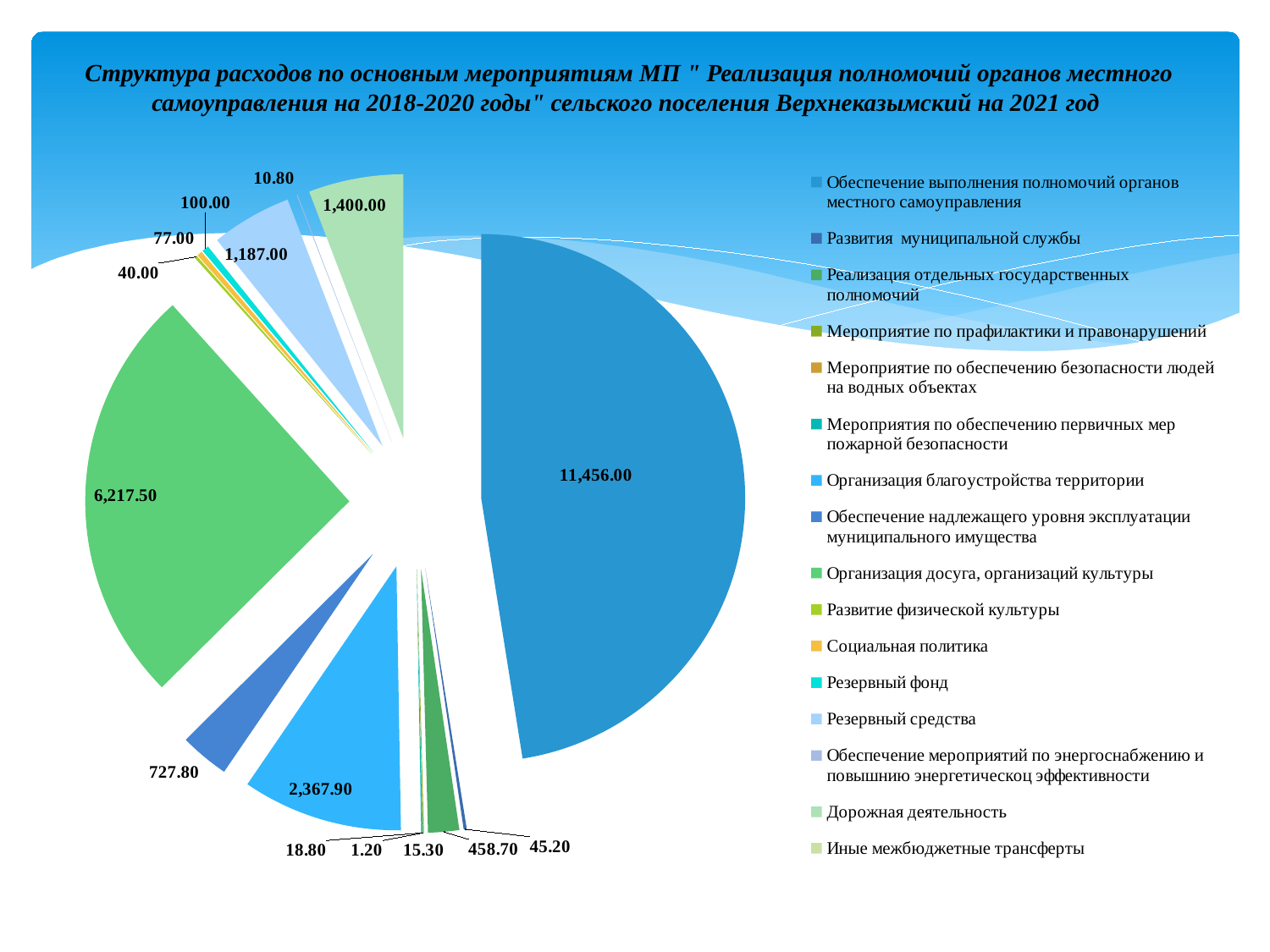
What is the value shown for Резервный средства? 1,187.00 What kind of chart is shown on the slide? pie chart What is the value shown for Дорожная деятельность? 1,400.00 How many categories does the legend list? 16 Which is larger: the value for Организация благоустройства территории or for Обеспечение надлежащего уровня эксплуатации муниципального имущества? Организация благоустройства территории Which category has the largest slice in the pie chart? Обеспечение выполнения полномочий органов местного самоуправления What is the difference between the values for Обеспечение выполнения полномочий органов местного самоуправления and Организация досуга, организаций культуры? 5,238.50 What is the value shown for Организация благоустройства территории? 2,367.90 What is the value shown for Организация досуга, организаций культуры? 6,217.50 What is the value of the largest slice in the pie chart? 11,456.00 What is the smallest data label value shown on the pie chart? 1.20 What is the value shown for Обеспечение надлежащего уровня эксплуатации муниципального имущества? 727.80